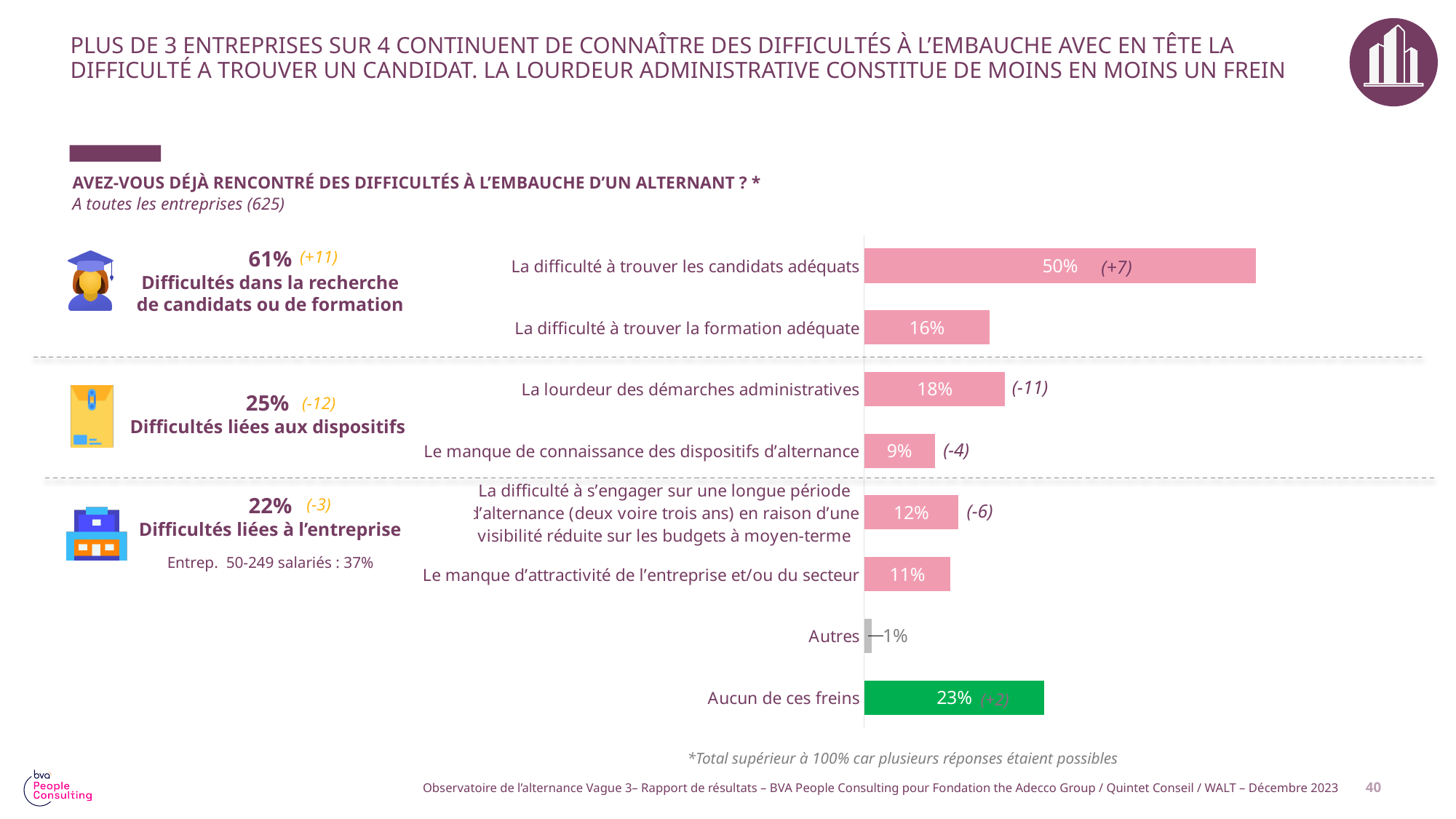
Which is larger: the value for "La lourdeur des démarches administratives" or the value for "La difficulté à trouver la formation adéquate"? La lourdeur des démarches administratives Which bar in the chart is coloured green rather than pink? Aucun de ces freins Which category has the lowest value in the bar chart? Autres What is the change indicated in parentheses next to the 50% bar for "La difficulté à trouver les candidats adéquats"? (+7) What is the value shown for "Le manque de connaissance des dispositifs d'alternance"? 9% What is the difference between the values for "La difficulté à trouver les candidats adéquats" and "La difficulté à trouver la formation adéquate"? 34% What is the value shown for "Aucun de ces freins"? 23% What percentage of companies cite "La difficulté à trouver les candidats adéquats" as a difficulty? 50% How many categories are plotted in the bar chart? 8 What is the value shown for "La lourdeur des démarches administratives"? 18% What kind of chart is shown on the slide? Bar chart Which category has the highest value in the bar chart? La difficulté à trouver les candidats adéquats